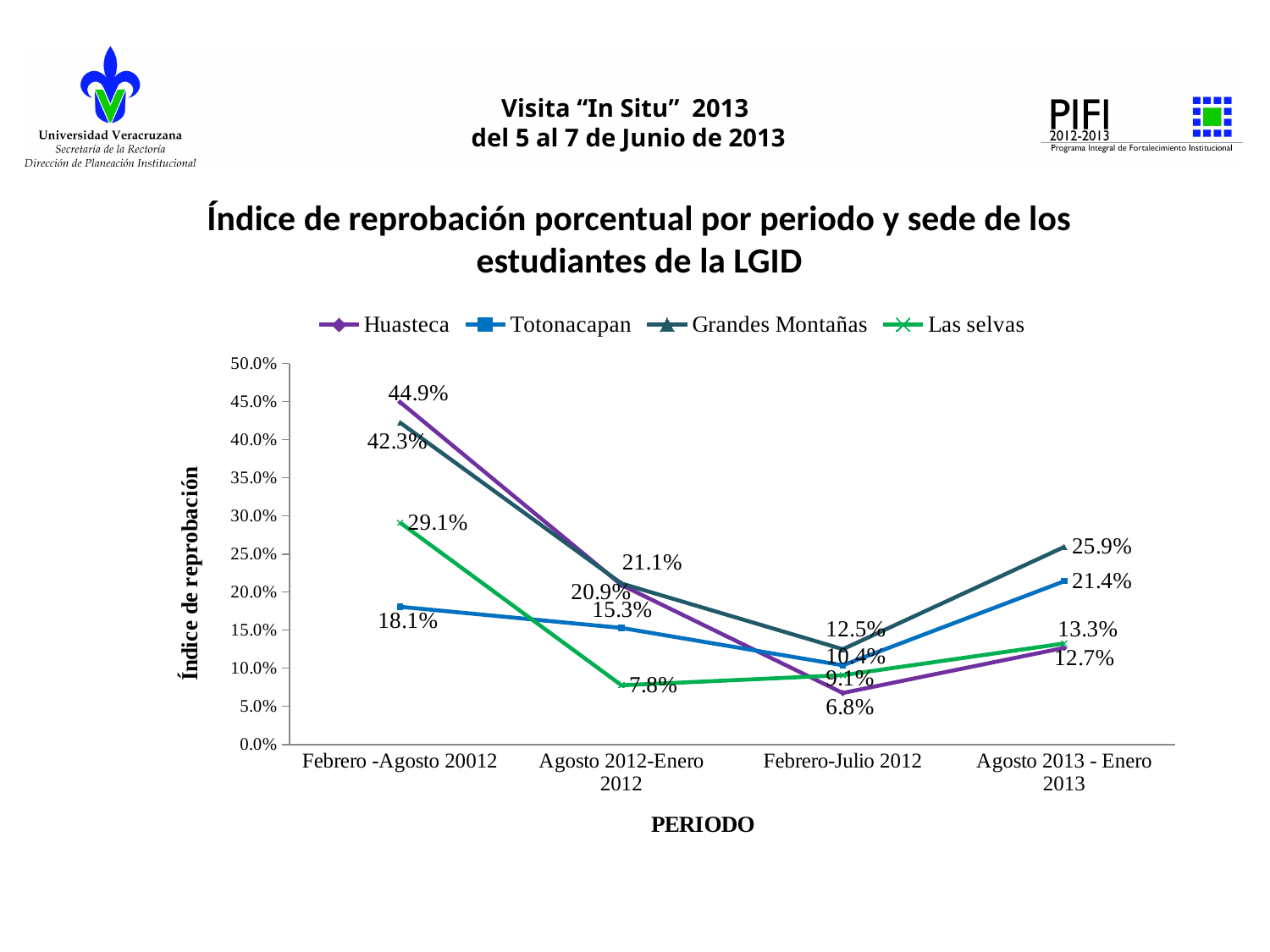
What is the value for Las selvas in the period Agosto 2012-Enero 2012? 7.8% What is the difference between the Huasteca value and the Totonacapan value in the period Febrero -Agosto 20012? 26.8% How many periods are shown on the x axis? 4 Which series has the highest value in the period Febrero -Agosto 20012? Huasteca What is the value for Totonacapan in the period Febrero -Agosto 20012? 18.1% What is the value for Grandes Montañas in the period Agosto 2013 - Enero 2013? 25.9% What type of chart is shown on the slide? line chart How many series does the legend list? 4 What is the value for Huasteca in the period Febrero -Agosto 20012? 44.9% Which series has the lowest value in the period Febrero-Julio 2012? Huasteca In the period Agosto 2013 - Enero 2013, which is larger: the value for Grandes Montañas or the value for Las selvas? Grandes Montañas Does the Huasteca series rise or fall from Febrero -Agosto 20012 to Febrero-Julio 2012? fall